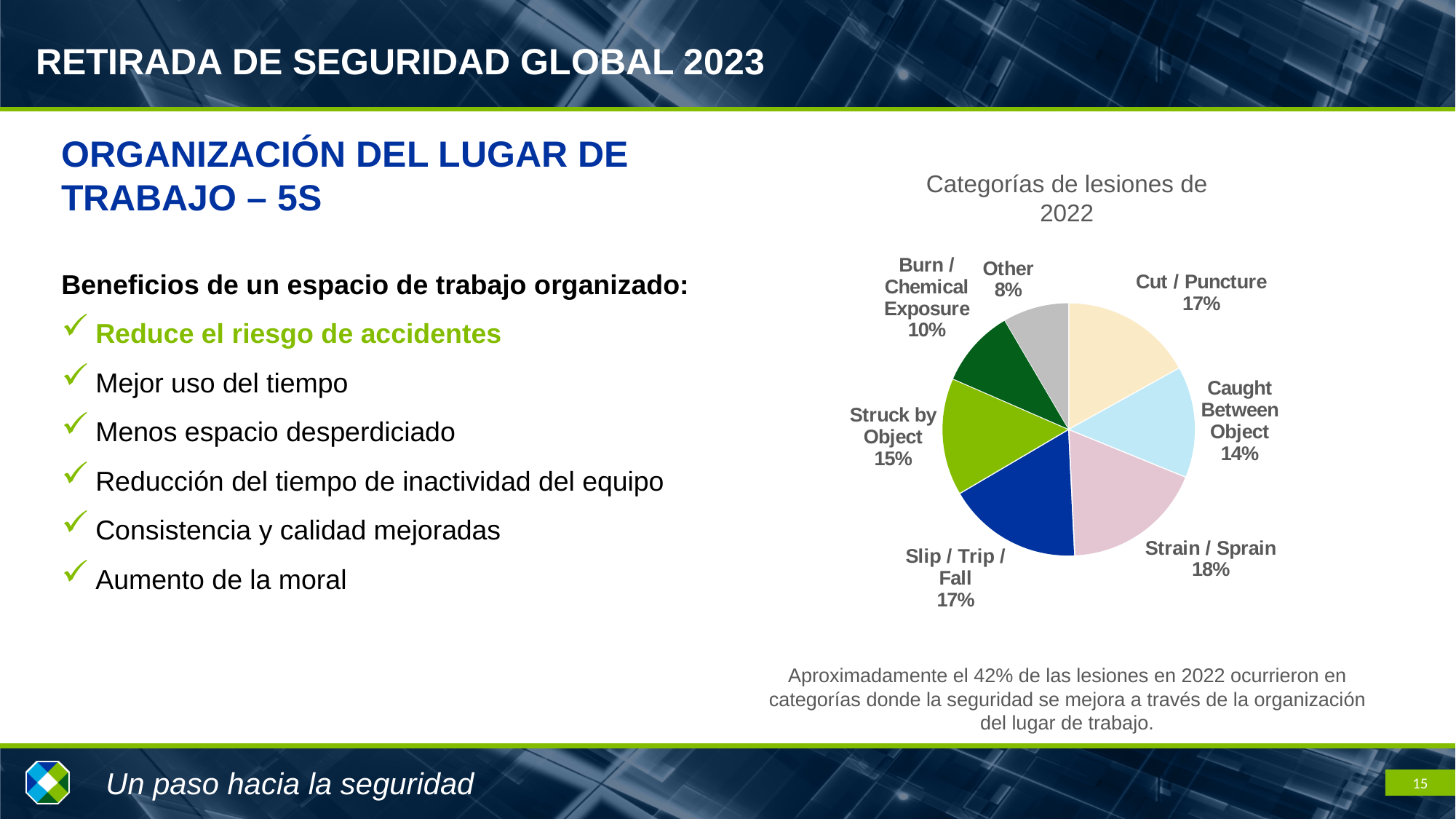
What is the title of the chart? Categorías de lesiones de 2022 How many injury categories are shown in the pie chart? 7 What is the difference in percentage points between Strain / Sprain and Other? 10 What type of chart is shown on the slide? pie chart What percentage of injuries is attributed to Struck by Object? 15% Which has a larger share, Struck by Object or Caught Between Object? Struck by Object What percentage of injuries is attributed to Burn / Chemical Exposure? 10% Which injury category has the largest share? Strain / Sprain What percentage of injuries is attributed to Caught Between Object? 14% What is the combined share of Cut / Puncture and Slip / Trip / Fall? 34% What percentage of injuries is attributed to Strain / Sprain? 18% Which injury category has the smallest share? Other